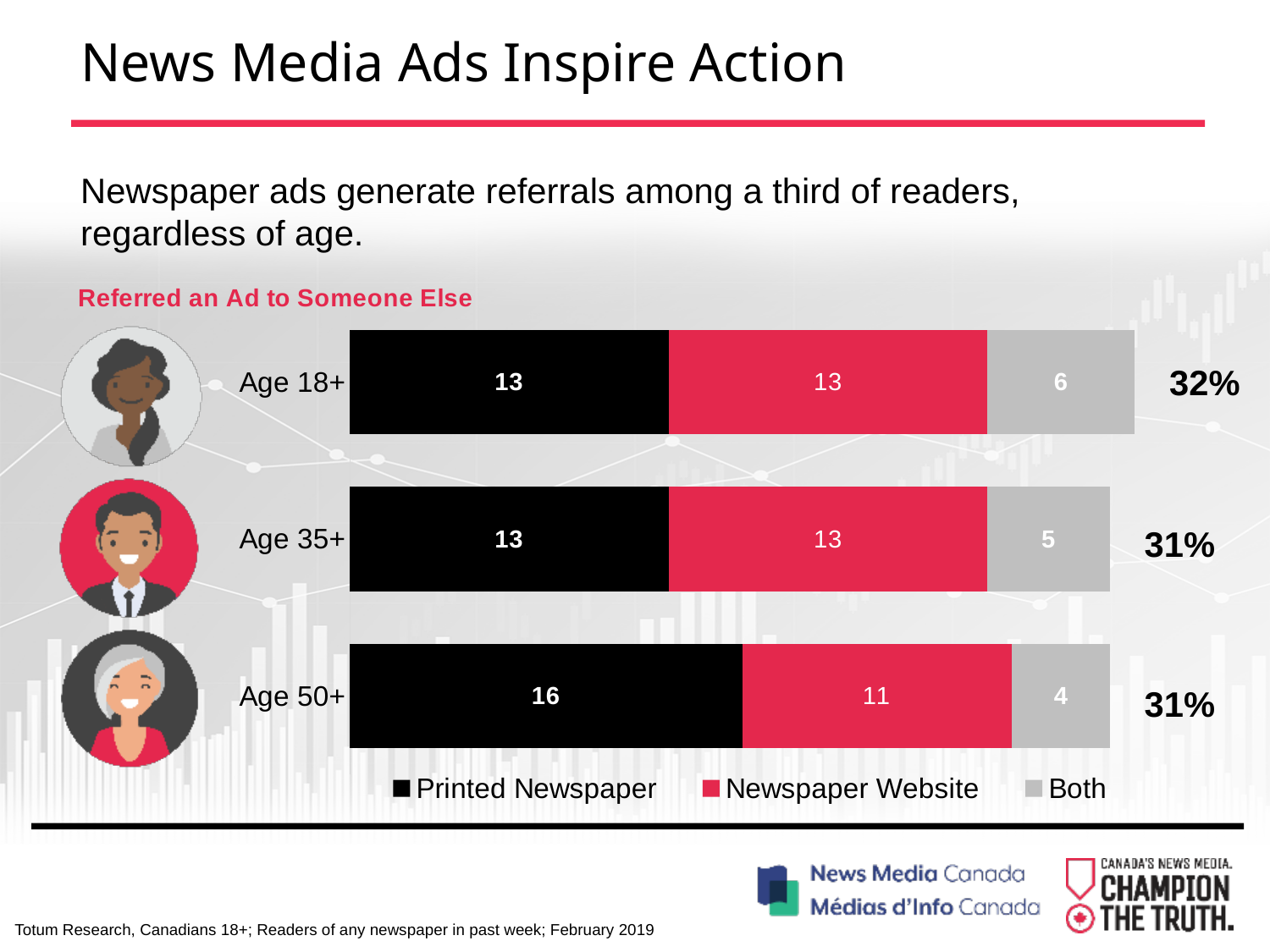
Is the Both value larger for Age 18+ or Age 50+? Age 18+ What kind of chart is shown? Stacked bar chart What is the Printed Newspaper value for Age 50+? 16 What is the title of the chart? Referred an Ad to Someone Else Which age group has the highest Printed Newspaper value? Age 50+ What is the difference between the Printed Newspaper and Newspaper Website values for Age 50+? 5 How many age groups are shown in the chart? 3 What is the Newspaper Website value for Age 18+? 13 Which age group has the lowest Both value? Age 50+ What is the total shown for the Age 18+ bar? 32% How many series does the legend list? 3 What is the Both value for Age 35+? 5